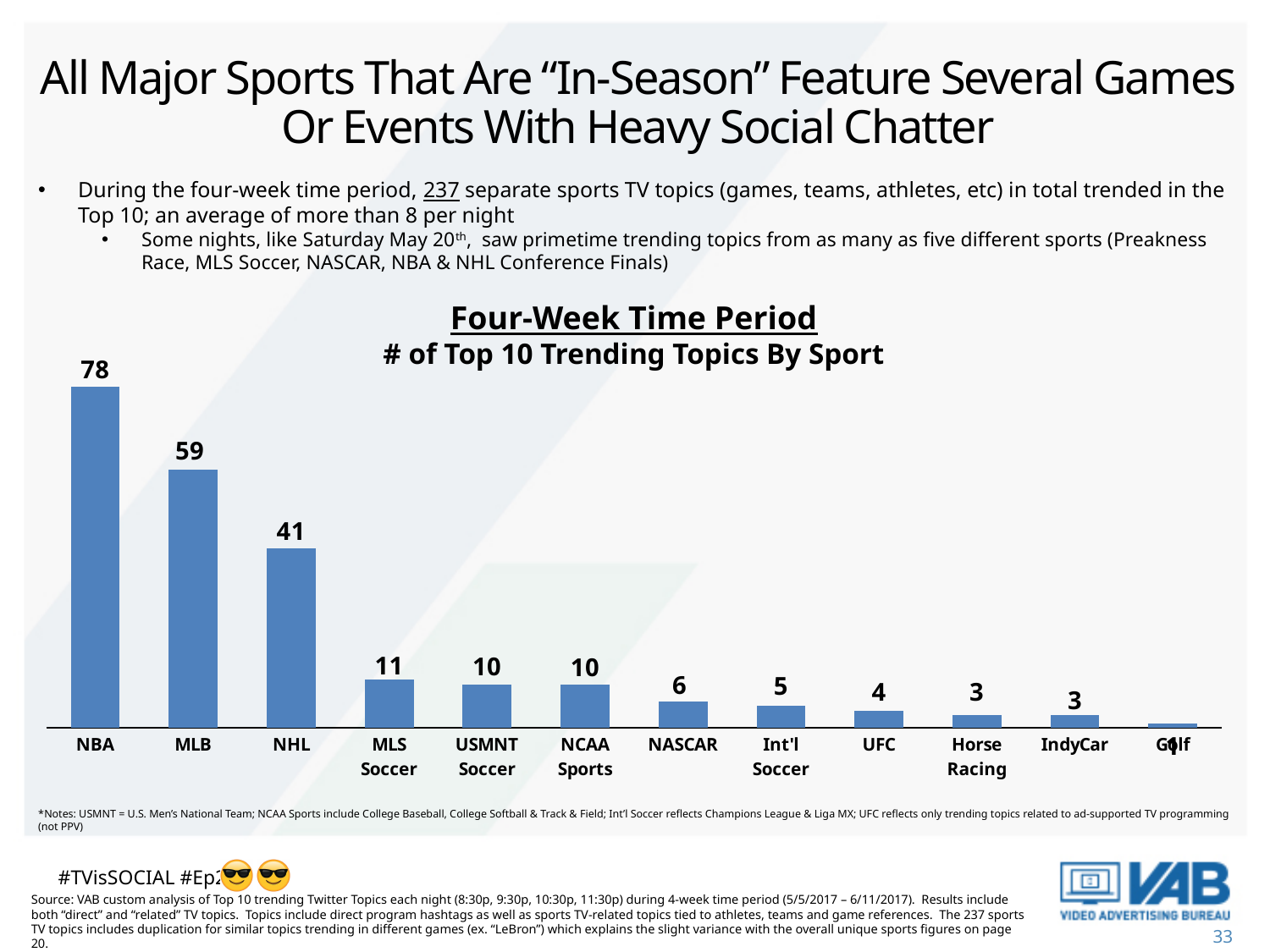
What is the value for NHL? 41 What is the value for NBA? 78 What is the value for NASCAR? 6 How many sports categories are shown in the chart? 12 What is the difference between the values for NHL and MLS Soccer? 30 What is the difference between the values for NBA and MLB? 19 What is the value for Horse Racing? 3 What is the value for MLB? 59 What kind of chart is shown on the slide? Bar chart Which sport has the highest number of Top 10 trending topics? NBA What is the title of the chart? Four-Week Time Period # of Top 10 Trending Topics By Sport Which is larger, the value for MLS Soccer or the value for NASCAR? MLS Soccer